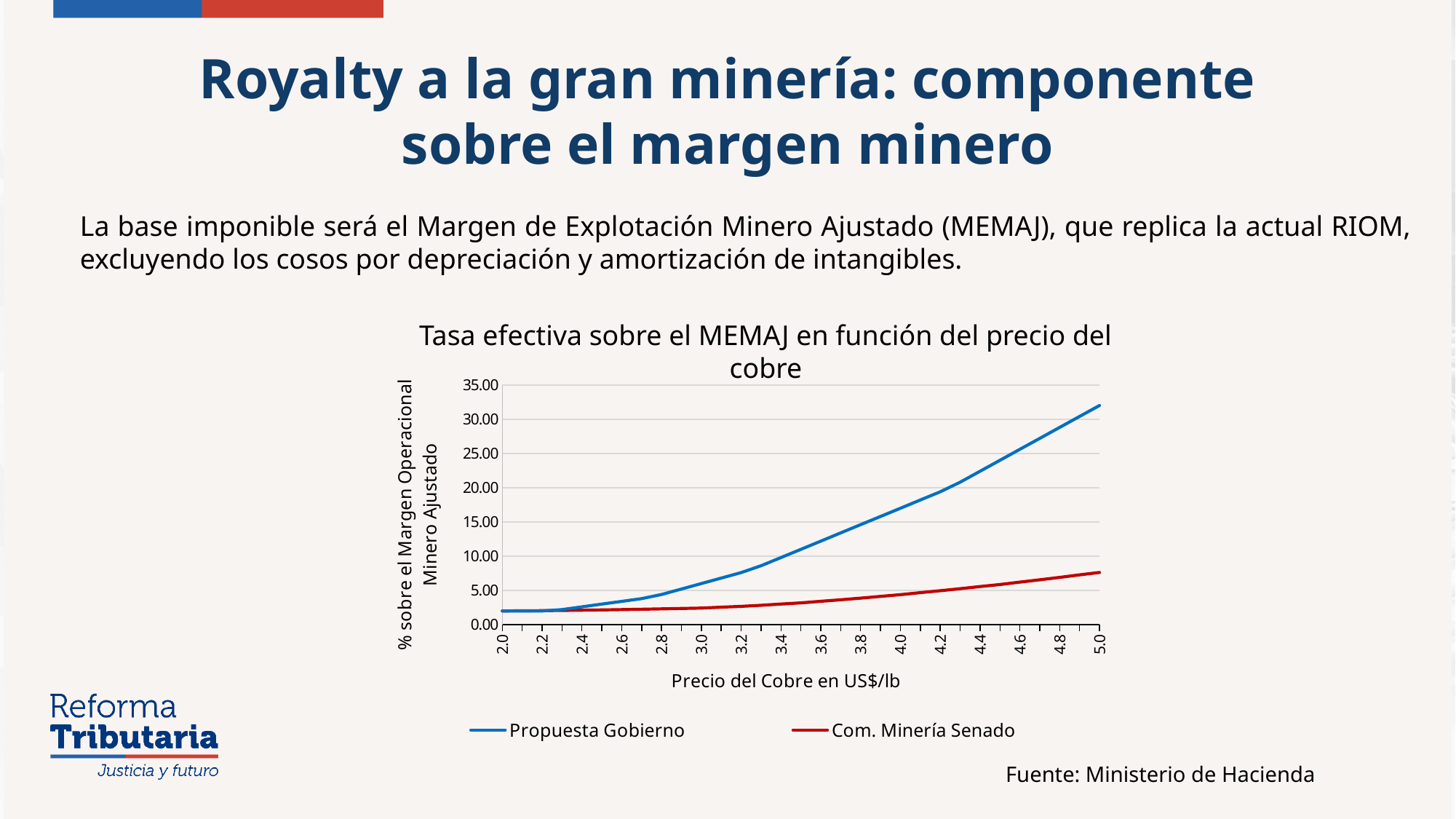
Does the Propuesta Gobierno line rise or fall as the copper price increases from 2.0 to 5.0? rise What is the title of the chart? Tasa efectiva sobre el MEMAJ en función del precio del cobre Is the value for Propuesta Gobierno at a copper price of 4.0 greater or less than 15.00? greater How many copper price points are marked on the x axis of the chart? 16 What kind of chart is shown on the slide? line chart Does the Com. Minería Senado line rise or fall as the copper price increases along the x axis? rise Is the value for Propuesta Gobierno at a copper price of 3.0 greater or less than 10.00? less What are the two series named in the chart legend? Propuesta Gobierno and Com. Minería Senado At a copper price of 5.0 US$/lb, which series has the higher effective rate, Propuesta Gobierno or Com. Minería Senado? Propuesta Gobierno Is the value for Propuesta Gobierno at a copper price of 5.0 greater or less than 30.00? greater How many series does the chart legend list? 2